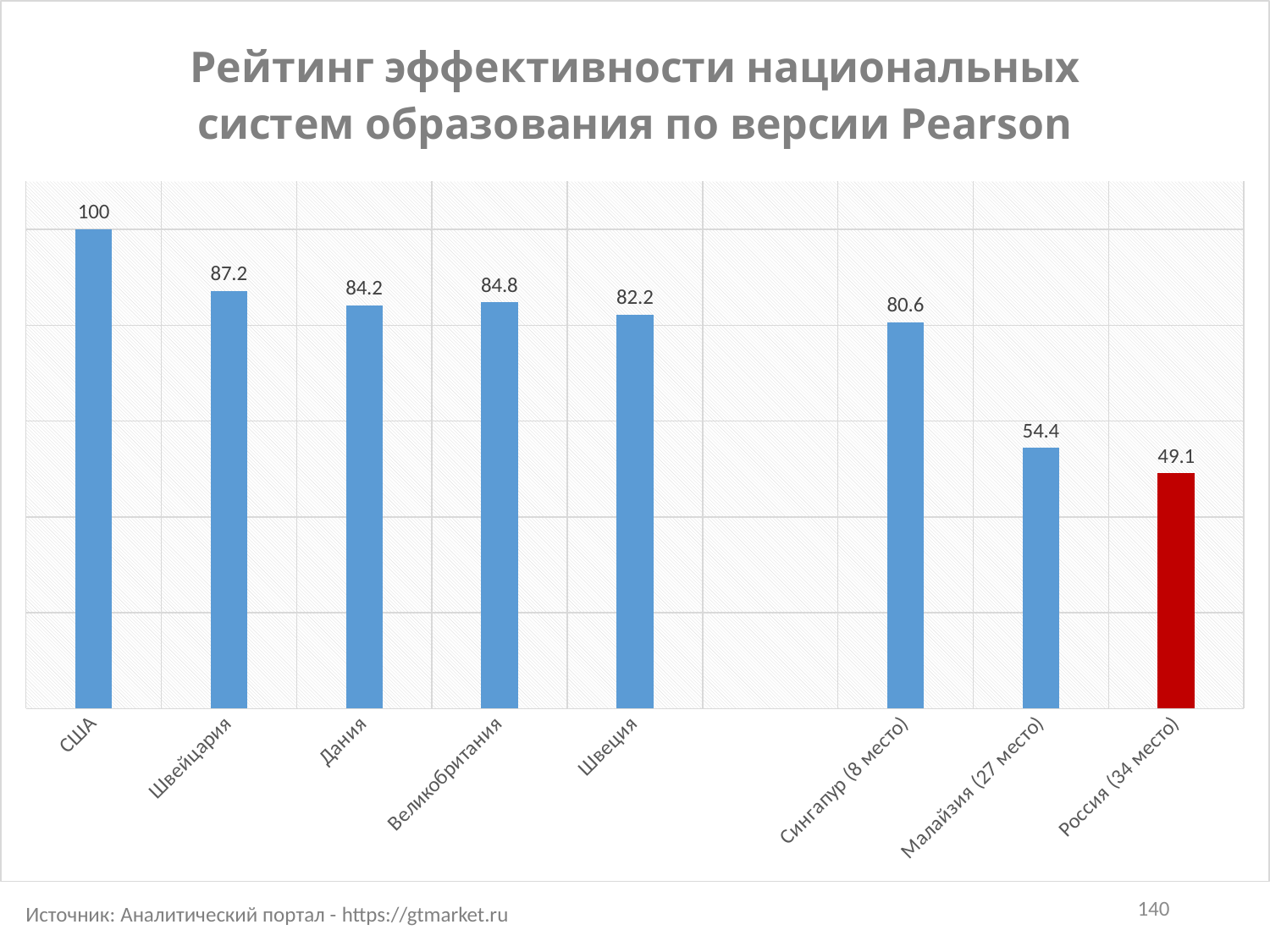
What is the value for Сингапур (8 место)? 80.6 Which country has the lowest value? Россия (34 место) Which country has the highest value? США What is the difference between the values for США and Россия (34 место)? 50.9 Which is larger, the value for Дания or the value for Великобритания? Великобритания How many countries are shown in the chart? 8 What kind of chart is shown on the slide? Bar chart What is the value for США? 100 What is the difference between the values for Малайзия (27 место) and Россия (34 место)? 5.3 Which bar is coloured red instead of blue? Россия (34 место) What is the value for Швейцария? 87.2 What is the value for Россия (34 место)? 49.1